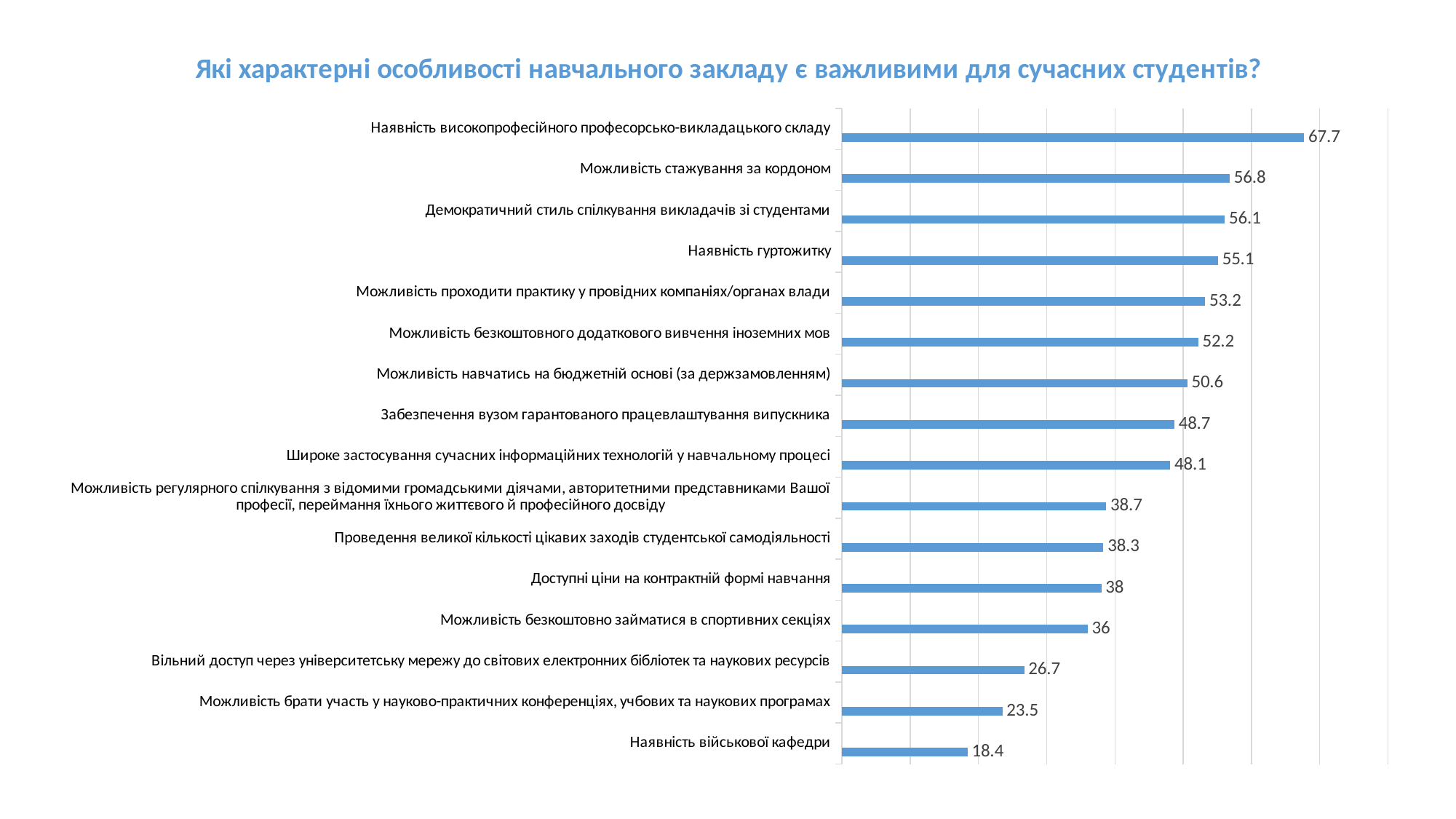
What is the value for "Доступні ціни на контрактній формі навчання"? 38 Which category has the lowest value? Наявність військової кафедри Which category has the highest value? Наявність високопрофесійного професорсько-викладацького складу What type of chart is shown on the slide? bar chart Do the bar values rise or fall going from the top of the chart to the bottom? fall Which is larger: the value for "Можливість проходити практику у провідних компаніях/органах влади" or the value for "Забезпечення вузом гарантованого працевлаштування випускника"? Можливість проходити практику у провідних компаніях/органах влади What is the title of the chart? Які характерні особливості навчального закладу є важливими для сучасних студентів? What is the difference between the values for "Наявність високопрофесійного професорсько-викладацького складу" and "Наявність військової кафедри"? 49.3 How many categories are plotted in the chart? 16 What is the value for "Наявність гуртожитку"? 55.1 What is the difference between the values for "Можливість безкоштовно займатися в спортивних секціях" and "Вільний доступ через університетську мережу до світових електронних бібліотек та наукових ресурсів"? 9.3 What is the value for "Можливість стажування за кордоном"? 56.8